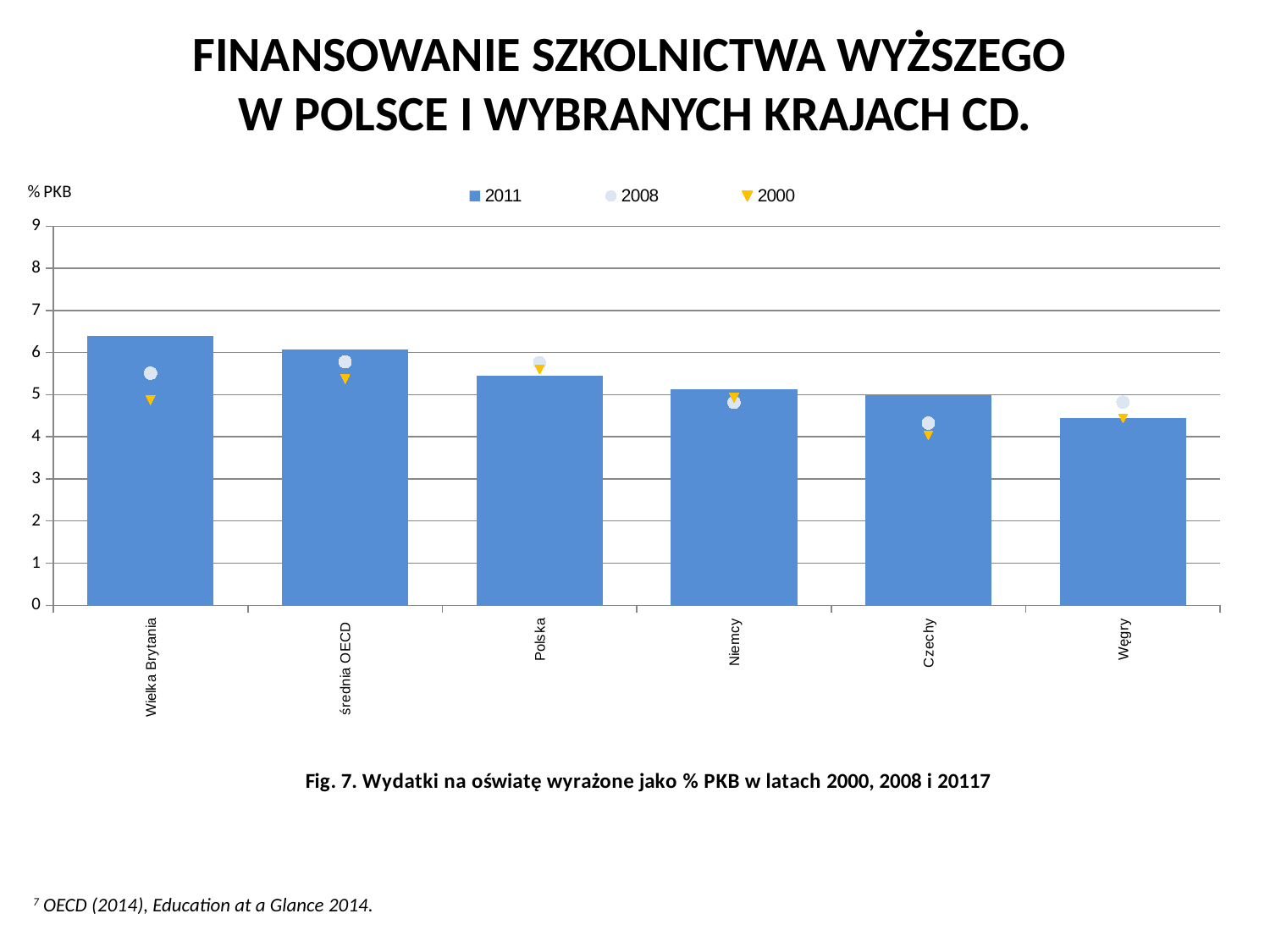
Which category has the lowest 2011 bar? Węgry How many series does the legend list? 3 Is the 2011 value for Polska greater or less than 5? greater What kind of chart is shown on the slide? bar chart Is the 2008 value for Czechy greater or less than 5? less Is the 2011 value for Węgry greater or less than 5? less Which years are listed in the chart legend? 2011, 2008, 2000 Which category has the highest 2011 bar? Wielka Brytania Do the 2011 bars rise or fall from left to right across the x axis? fall Which has a higher 2011 value, Wielka Brytania or Polska? Wielka Brytania How many countries/categories are shown on the x axis? 6